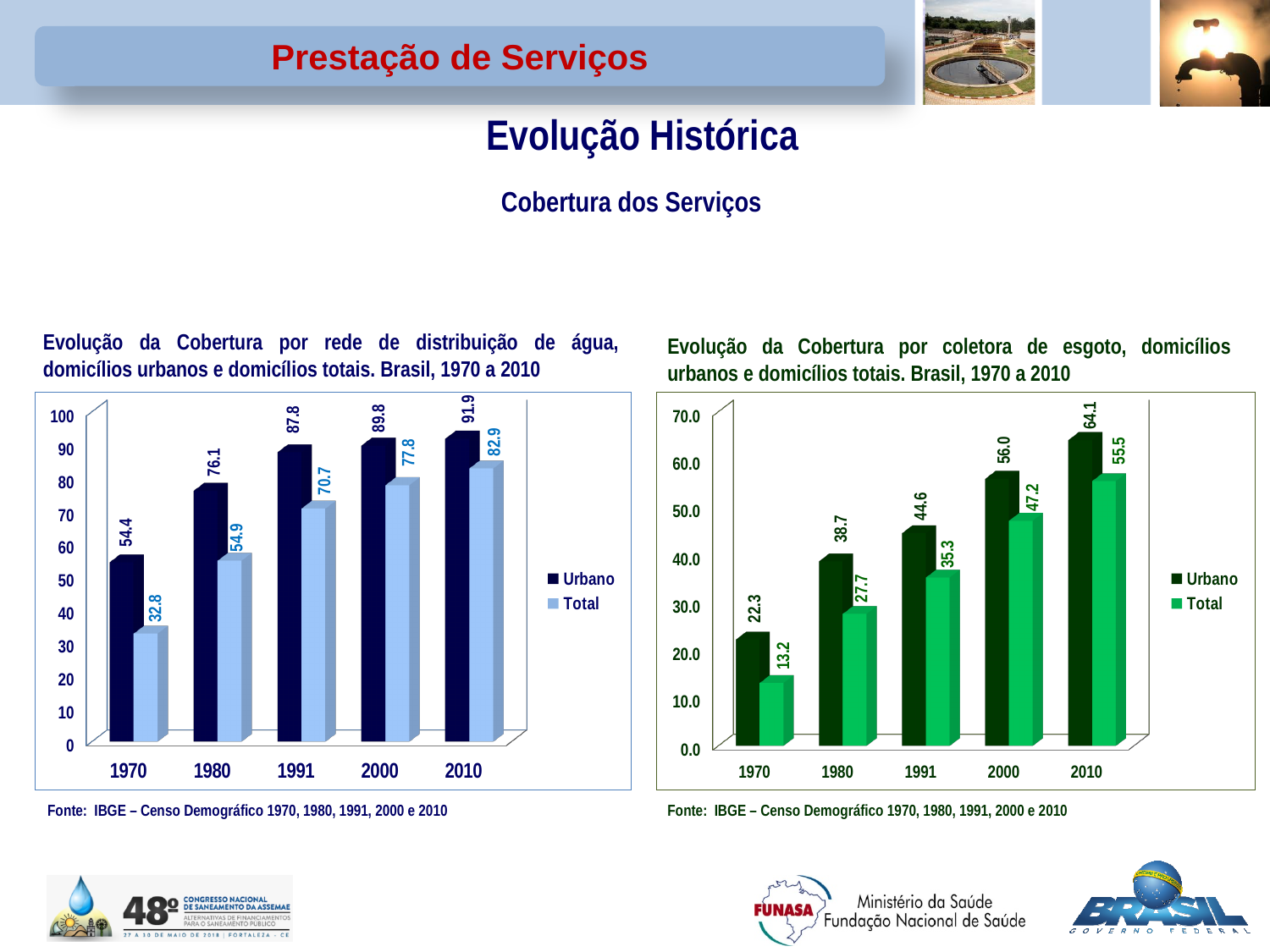
In the right chart (sewage collection coverage), what is the difference between the Urbano values for 2010 and 1970? 41.8 What type of chart is the left chart? Bar chart In the left chart (water distribution coverage), what is the Total value for 2010? 82.9 How many series does the legend of the right chart list? 2 In the right chart (sewage collection coverage), what is the Total value for 1991? 35.3 In the left chart (water distribution coverage), what is the Urbano value for 1970? 54.4 In the left chart (water distribution coverage), what is the difference between the Urbano and Total values for 1980? 21.2 In the right chart (sewage collection coverage), which is larger: the Urbano value for 1991 or the Total value for 2000? Total value for 2000 In the left chart (water distribution coverage), which year has the lowest Total value? 1970 How many years are shown on the x axis of the left chart? 5 In the right chart (sewage collection coverage), which year has the highest Urbano value? 2010 In the right chart (sewage collection coverage), do the Total values rise or fall from 1970 to 2010? Rise